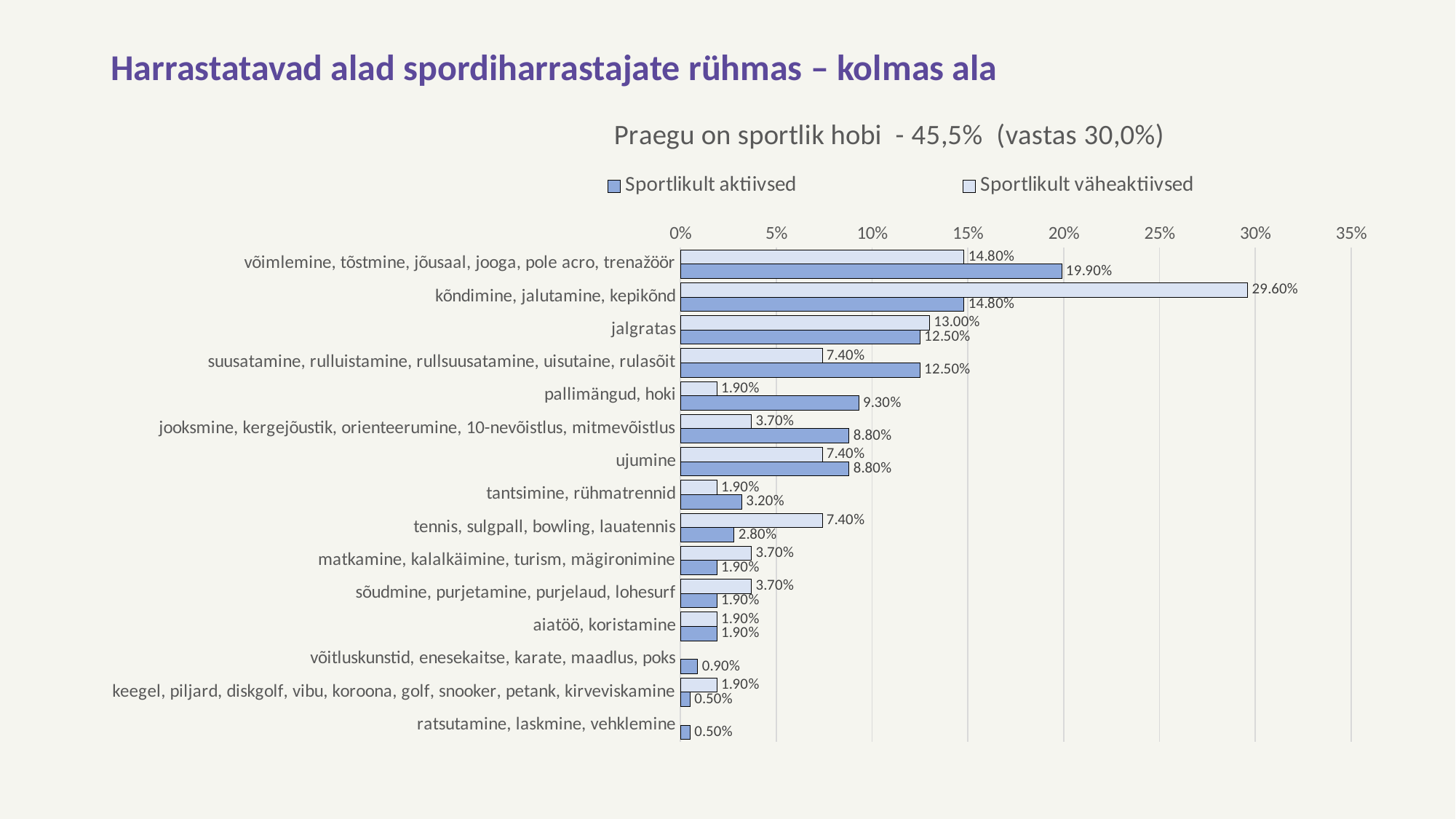
What kind of chart is shown on the slide? bar chart Which category has the highest value for 'Sportlikult aktiivsed'? võimlemine, tõstmine, jõusaal, jooga, pole acro, trenažöör What is the value for 'Sportlikult aktiivsed' in the category 'jalgratas'? 12.50% What is the value for 'Sportlikult väheaktiivsed' in the category 'kõndimine, jalutamine, kepikõnd'? 29.60% Is the 'Sportlikult aktiivsed' value for 'võimlemine, tõstmine, jõusaal, jooga, pole acro, trenažöör' greater or less than 15%? greater For 'tennis, sulgpall, bowling, lauatennis', which series has the larger value: 'Sportlikult aktiivsed' or 'Sportlikult väheaktiivsed'? Sportlikult väheaktiivsed How many series does the legend list? 2 What is the title of the chart? Praegu on sportlik hobi - 45,5% (vastas 30,0%) What is the value for 'Sportlikult aktiivsed' in the category 'pallimängud, hoki'? 9.30% How many categories are shown on the chart? 15 Which category has the highest value for 'Sportlikult väheaktiivsed'? kõndimine, jalutamine, kepikõnd What is the difference between the 'Sportlikult aktiivsed' and 'Sportlikult väheaktiivsed' values for 'pallimängud, hoki'? 7.40%